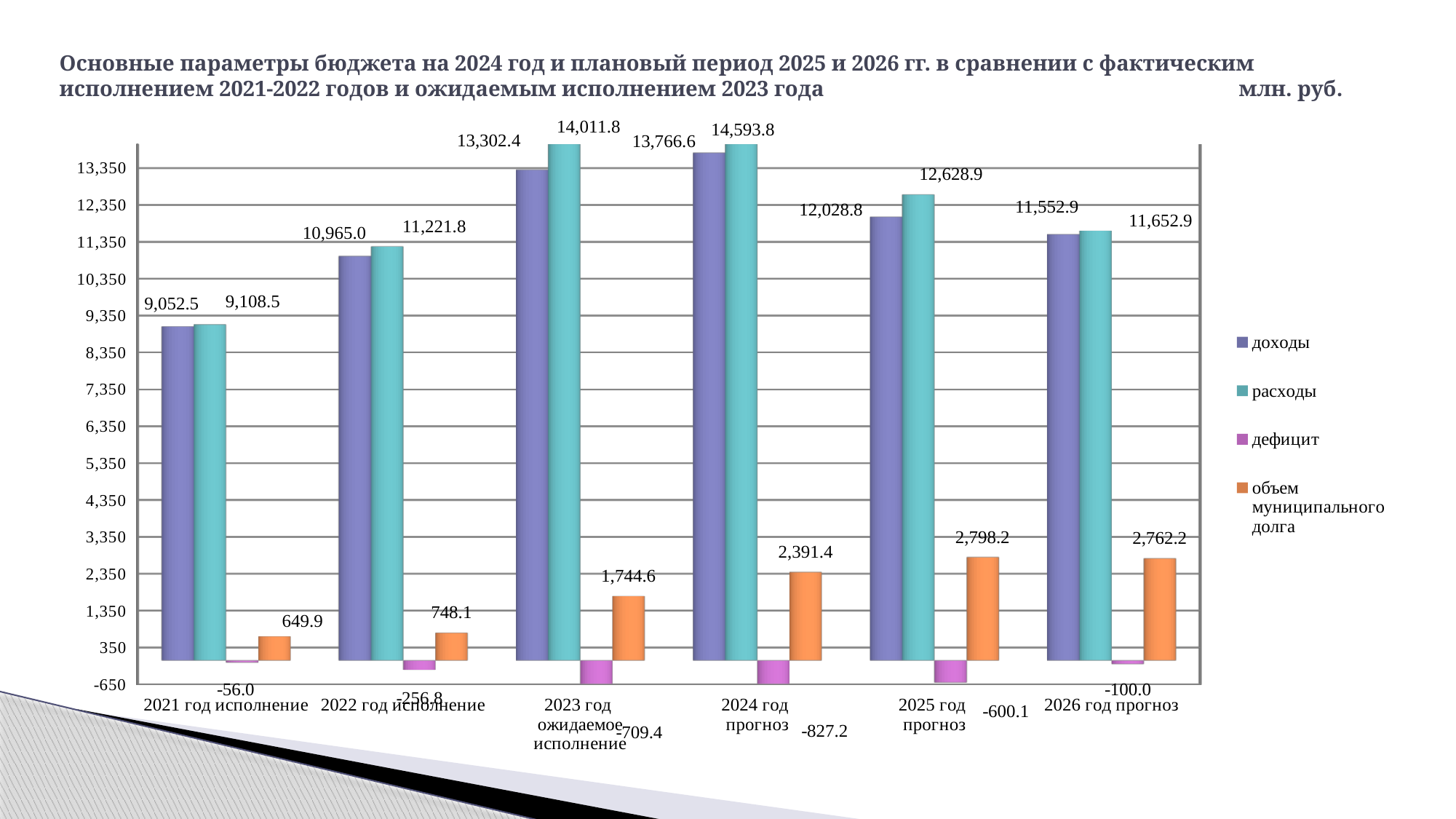
Which category has the lowest value for объем муниципального долга? 2021 год исполнение How many categories are shown on the x axis? 6 What is the value of доходы for 2021 год исполнение? 9,052.5 What is the value of дефицит for 2023 год ожидаемое исполнение? -709.4 What is the value of объем муниципального долга for 2025 год прогноз? 2,798.2 What kind of chart is shown on the slide? bar chart Which is larger: доходы for 2023 год ожидаемое исполнение or доходы for 2025 год прогноз? 2023 год ожидаемое исполнение What is the difference between расходы and доходы for 2026 год прогноз? 100.0 Which series is shown in orange in the legend? объем муниципального долга Which category has the highest value for расходы? 2024 год прогноз What is the value of расходы for 2024 год прогноз? 14,593.8 How many series does the legend list? 4